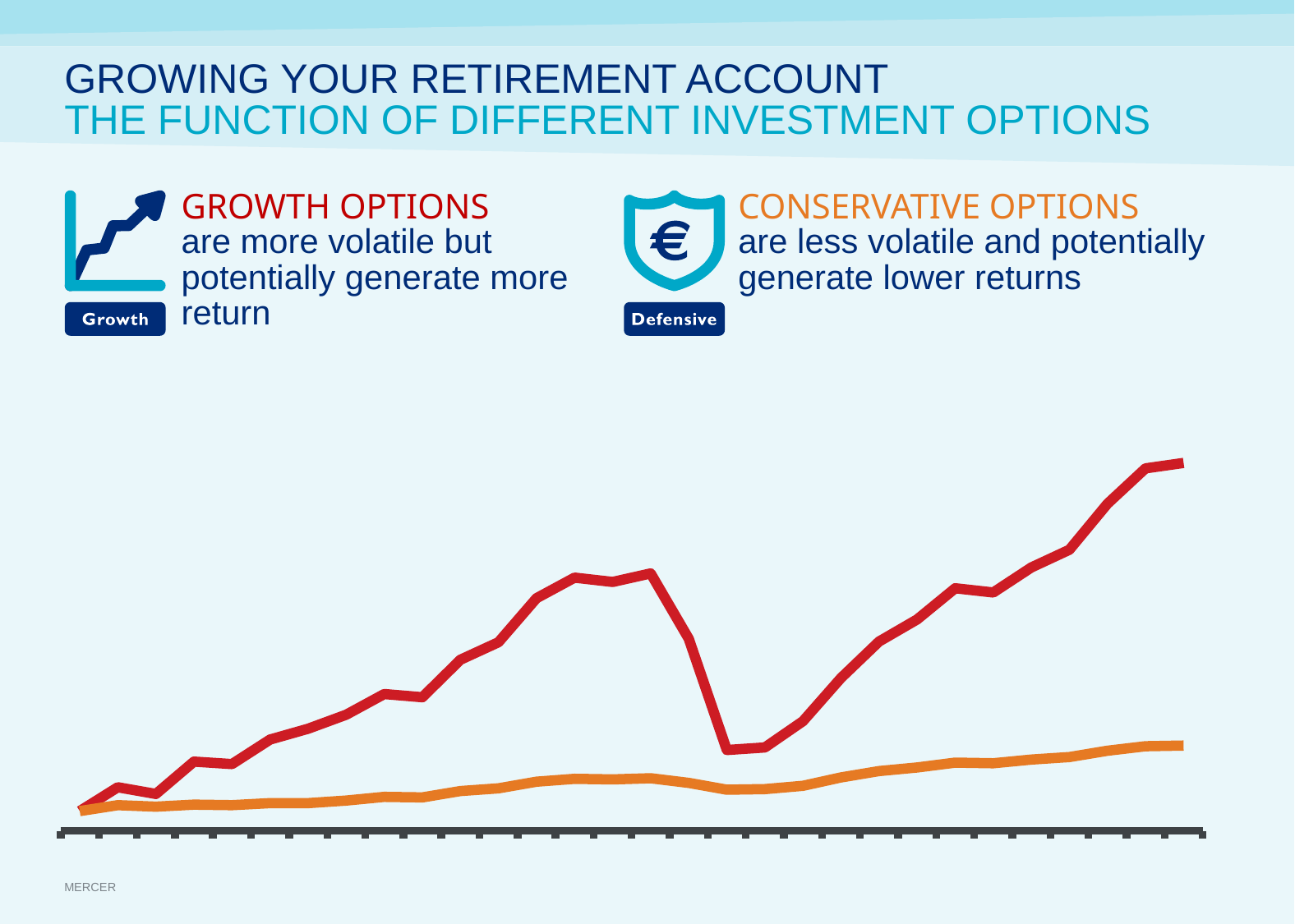
Does the orange line on the chart generally rise or fall from left to right? rise How many lines are plotted on the chart? 2 Which investment option does the red line on the chart represent? Growth options Do the red and orange lines start at roughly the same level at the left of the chart? yes At the right-hand end of the chart, which line is higher, the red line or the orange line? the red line Does the red line on the chart show a sharp drop partway along the x axis? yes Which line on the chart shows the larger swings up and down, the red line or the orange line? the red line Which investment option does the orange line on the chart represent? Conservative options Does the red line on the chart generally rise or fall from left to right? rise What kind of chart is shown at the bottom of the slide? line chart